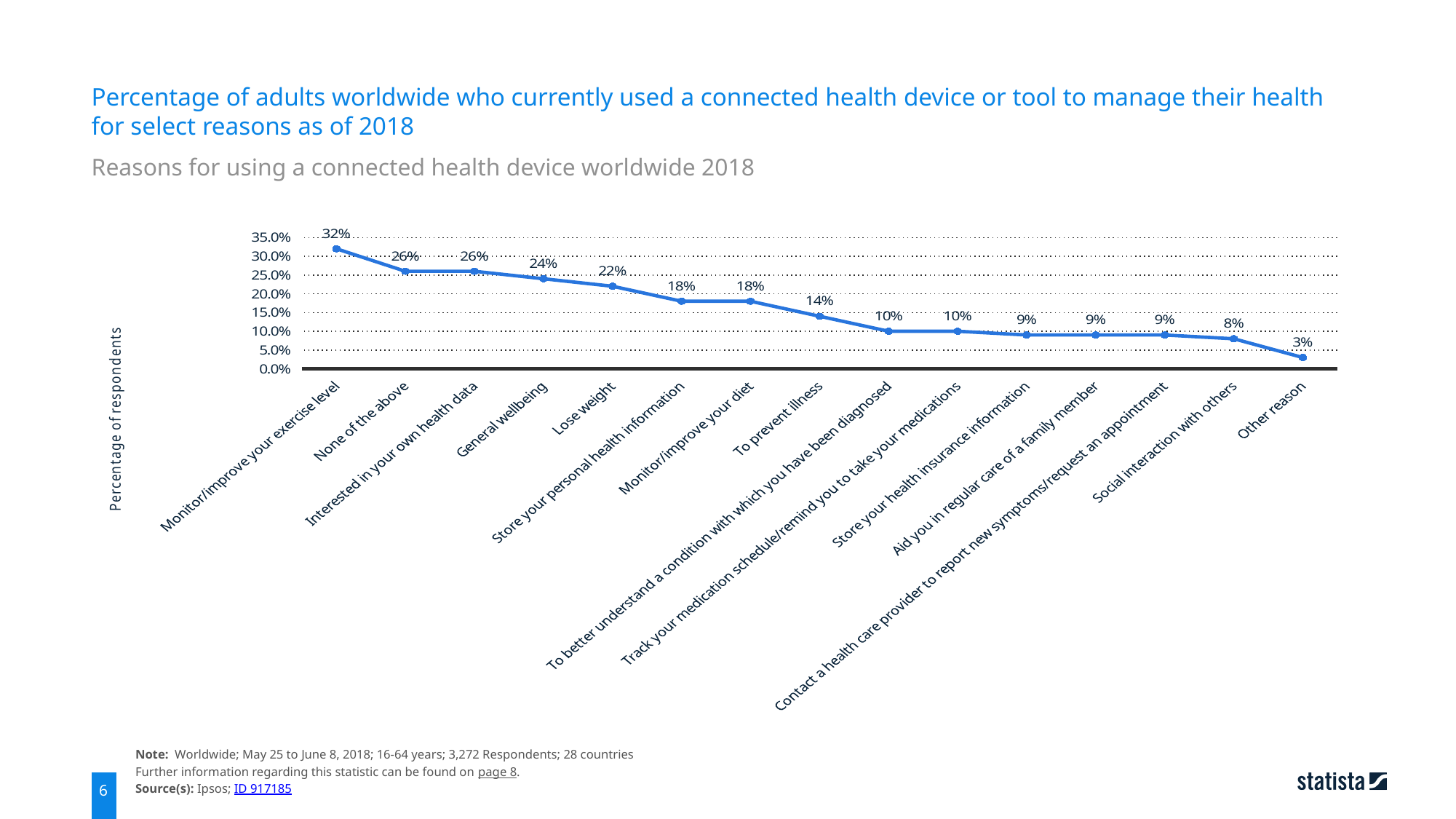
Which reason has the highest percentage of respondents? Monitor/improve your exercise level What kind of chart is shown on the slide? Line chart What is the difference between the values for 'Monitor/improve your exercise level' and 'General wellbeing'? 8% Which reason has the lowest percentage of respondents? Other reason What percentage of respondents selected 'To prevent illness'? 14% Which is larger: the value for 'Lose weight' or the value for 'Monitor/improve your diet'? Lose weight What percentage of respondents used a connected health device to monitor/improve their exercise level? 32% What is the value for 'Lose weight'? 22% What is the value for 'Social interaction with others'? 8% How many reasons are plotted on the chart? 15 Do the values rise or fall from left to right along the x axis? Fall What is the label of the vertical axis? Percentage of respondents